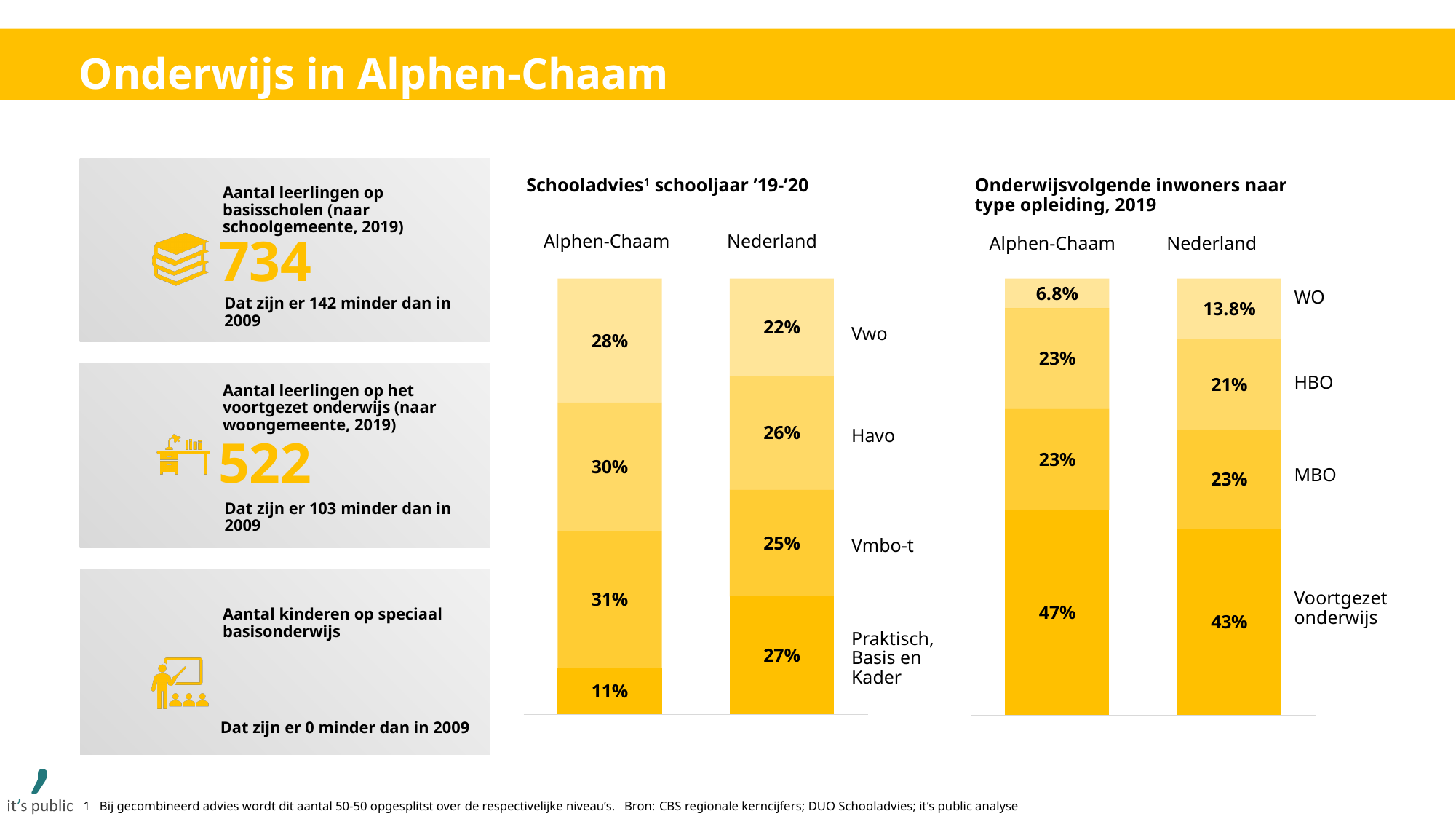
How many segments does each bar in the 'Onderwijsvolgende inwoners naar type opleiding, 2019' chart have? 4 What type of chart is the 'Schooladvies schooljaar '19-'20' chart? Stacked bar chart In the 'Onderwijsvolgende inwoners naar type opleiding, 2019' chart, what is the Voortgezet onderwijs share for Nederland? 43% In the 'Schooladvies schooljaar '19-'20' chart, what is the Praktisch, Basis en Kader share for Nederland? 27% In the 'Schooladvies schooljaar '19-'20' chart, which segment of the Alphen-Chaam bar is the smallest? Praktisch, Basis en Kader In the 'Schooladvies schooljaar '19-'20' chart, what is the difference between the Praktisch, Basis en Kader share for Nederland and for Alphen-Chaam? 16 percentage points In the 'Onderwijsvolgende inwoners naar type opleiding, 2019' chart, what is the WO share for Alphen-Chaam? 6.8% In the 'Schooladvies schooljaar '19-'20' chart, what percentage of the Alphen-Chaam bar is Vwo? 28% In the 'Onderwijsvolgende inwoners naar type opleiding, 2019' chart, which segment of the Nederland bar is the largest? Voortgezet onderwijs In the 'Onderwijsvolgende inwoners naar type opleiding, 2019' chart, what is the difference between the WO share for Nederland and for Alphen-Chaam? 7 percentage points In the 'Schooladvies schooljaar '19-'20' chart, is the Havo share larger for Alphen-Chaam or for Nederland? Alphen-Chaam In the 'Schooladvies schooljaar '19-'20' chart, which segment of the Alphen-Chaam bar is the largest? Vmbo-t